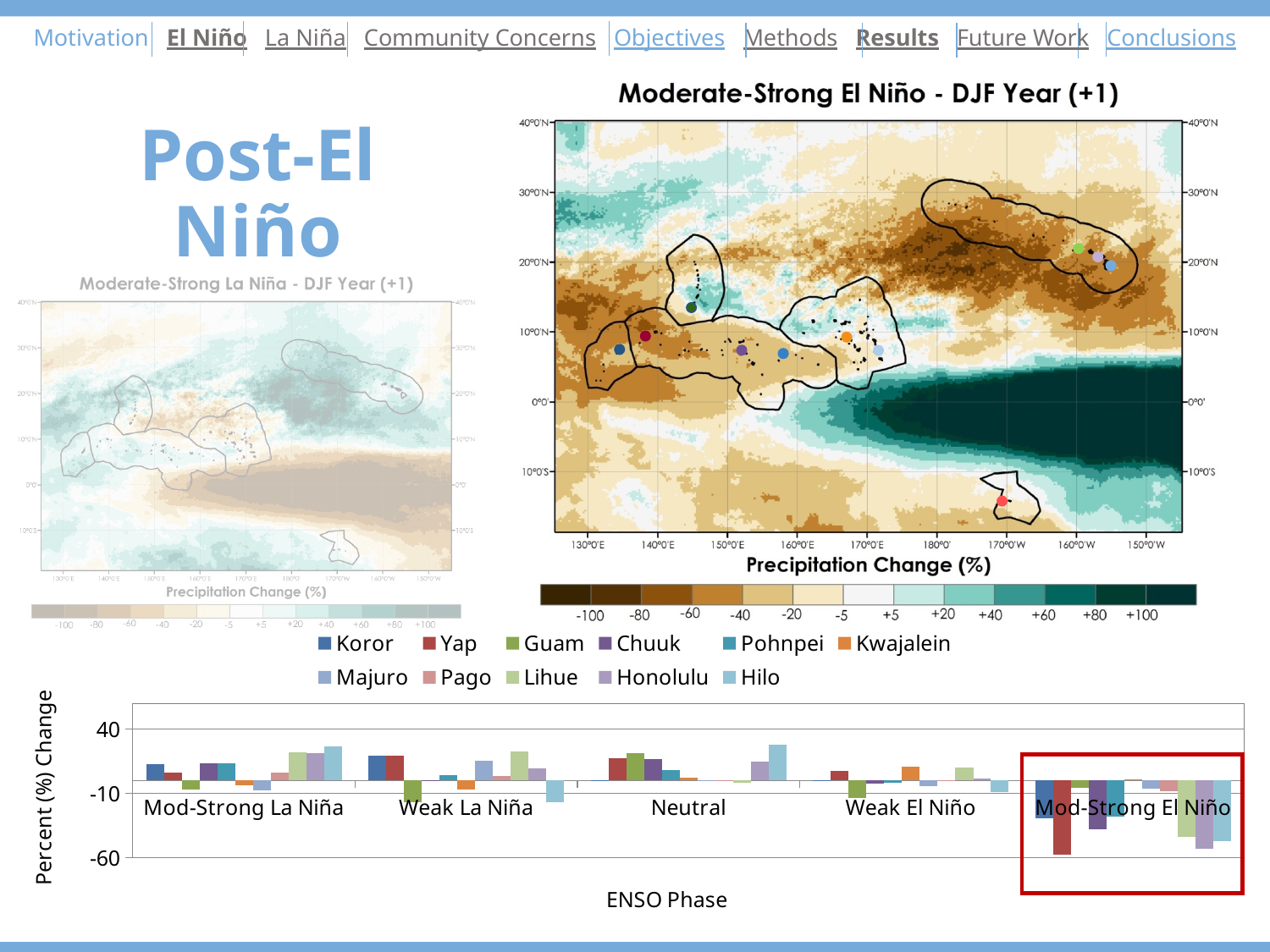
In the bar chart, is the value for Yap in the Mod-Strong El Niño phase greater or less than -10? less How many series does the legend of the bar chart list? 11 In the bar chart, is the value for Hilo in the Neutral phase greater or less than -10? greater In the bar chart, which series has the highest value in the Neutral phase? Hilo In the bar chart, is the value for Honolulu in the Mod-Strong El Niño phase greater or less than -10? less What kind of chart is shown at the bottom of the slide? bar chart How many ENSO phases are shown along the x axis of the bar chart? 5 In the bar chart, in which ENSO phase is the Yap bar lowest? Mod-Strong El Niño In the bar chart, which series has the lowest value in the Mod-Strong El Niño phase? Yap What is the title of the y axis of the bar chart? Percent (%) Change What is the title of the x axis of the bar chart? ENSO Phase